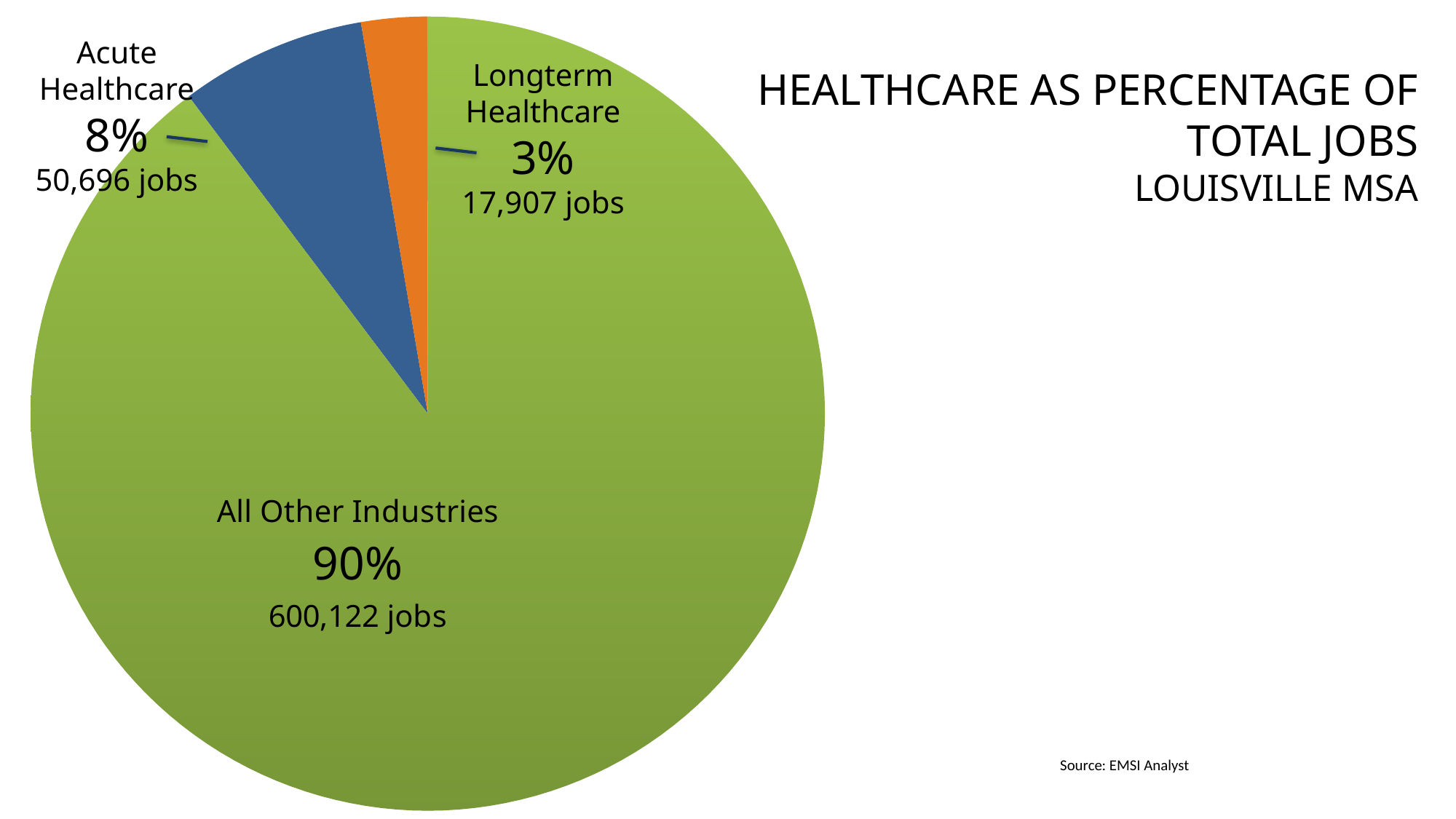
What is the difference in jobs between Acute Healthcare and Longterm Healthcare? 32,789 jobs How many jobs are in All Other Industries? 600,122 jobs What kind of chart is shown on the slide? Pie chart Which category has the largest slice of the pie? All Other Industries Which has more jobs, Acute Healthcare or Longterm Healthcare? Acute Healthcare Which category has the smallest slice of the pie? Longterm Healthcare How many categories are shown in the pie chart? 3 What colour is the Acute Healthcare slice? Blue What share of the pie does Longterm Healthcare hold? 3% What is the title of the chart? HEALTHCARE AS PERCENTAGE OF TOTAL JOBS LOUISVILLE MSA What percentage of total jobs does Acute Healthcare represent? 8% How many jobs are in Longterm Healthcare? 17,907 jobs